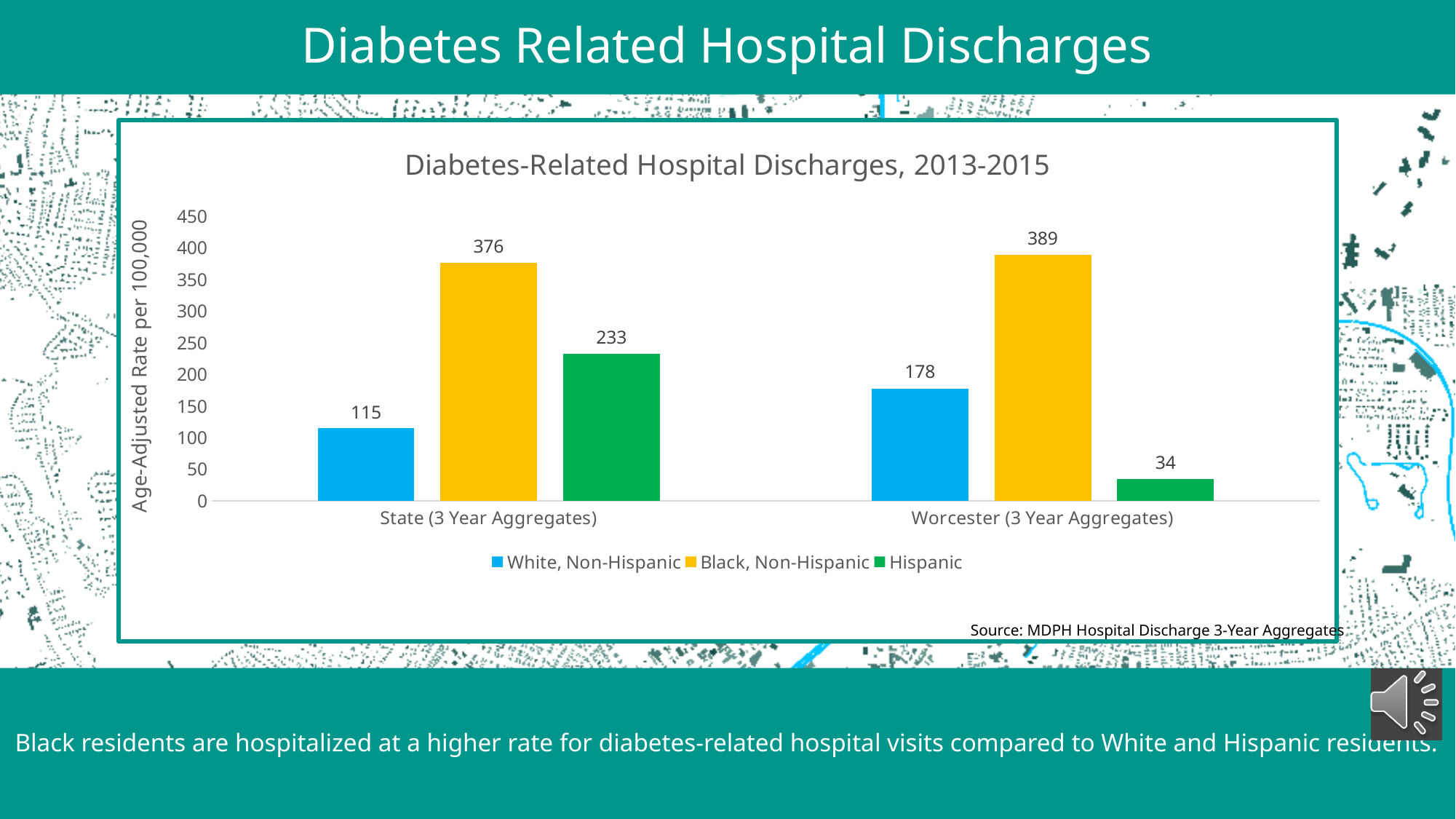
What is the difference between the Black, Non-Hispanic rate in Worcester and the Black, Non-Hispanic rate for the State? 13 What is the title of the chart? Diabetes-Related Hospital Discharges, 2013-2015 Which series has the lowest value in the State (3 Year Aggregates) category? White, Non-Hispanic What is the difference between the Hispanic rate for the State and the Hispanic rate for Worcester? 199 What kind of chart is shown on the slide? Bar chart What is the value for White, Non-Hispanic residents in Worcester (3 Year Aggregates)? 178 Is the White, Non-Hispanic rate higher for the State or for Worcester? Worcester What is the age-adjusted rate for Hispanic residents in Worcester (3 Year Aggregates)? 34 Which series has the highest value in the Worcester (3 Year Aggregates) category? Black, Non-Hispanic How many categories are shown on the x axis? 2 What is the age-adjusted rate for Black, Non-Hispanic residents in the State (3 Year Aggregates) category? 376 How many series does the legend list? 3